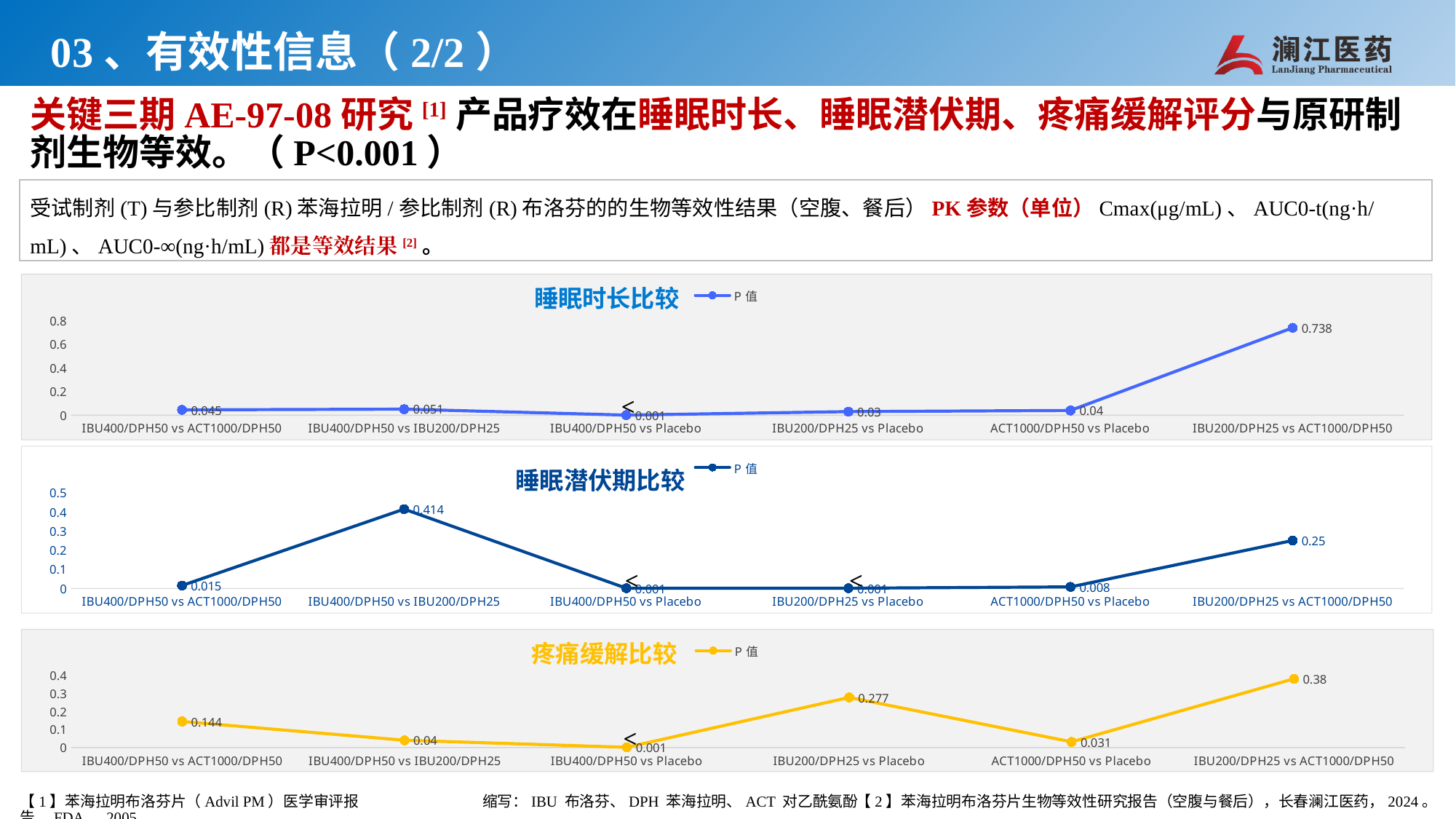
In the 疼痛缓解比较 chart, what is the P value for IBU200/DPH25 vs Placebo? 0.277 How many series does the legend of the 睡眠时长比较 chart list? 1 In the 睡眠时长比较 chart, which comparison has the highest P value? IBU200/DPH25 vs ACT1000/DPH50 In the 睡眠时长比较 chart, what is the P value for IBU200/DPH25 vs ACT1000/DPH50? 0.738 In the 睡眠时长比较 chart, what is the P value for IBU400/DPH50 vs IBU200/DPH25? 0.051 In the 睡眠潜伏期比较 chart, what is the difference between the P values for IBU400/DPH50 vs IBU200/DPH25 and IBU200/DPH25 vs ACT1000/DPH50? 0.164 In the 疼痛缓解比较 chart, which comparison has the highest P value? IBU200/DPH25 vs ACT1000/DPH50 In the 睡眠潜伏期比较 chart, what is the P value for IBU400/DPH50 vs IBU200/DPH25? 0.414 In the 疼痛缓解比较 chart, which is larger: the P value for IBU400/DPH50 vs ACT1000/DPH50 or for ACT1000/DPH50 vs Placebo? IBU400/DPH50 vs ACT1000/DPH50 How many comparisons are plotted on the x axis of the 疼痛缓解比较 chart? 6 What kind of chart is the 睡眠潜伏期比较 chart? Line chart In the 睡眠潜伏期比较 chart, which comparison has the highest P value? IBU400/DPH50 vs IBU200/DPH25